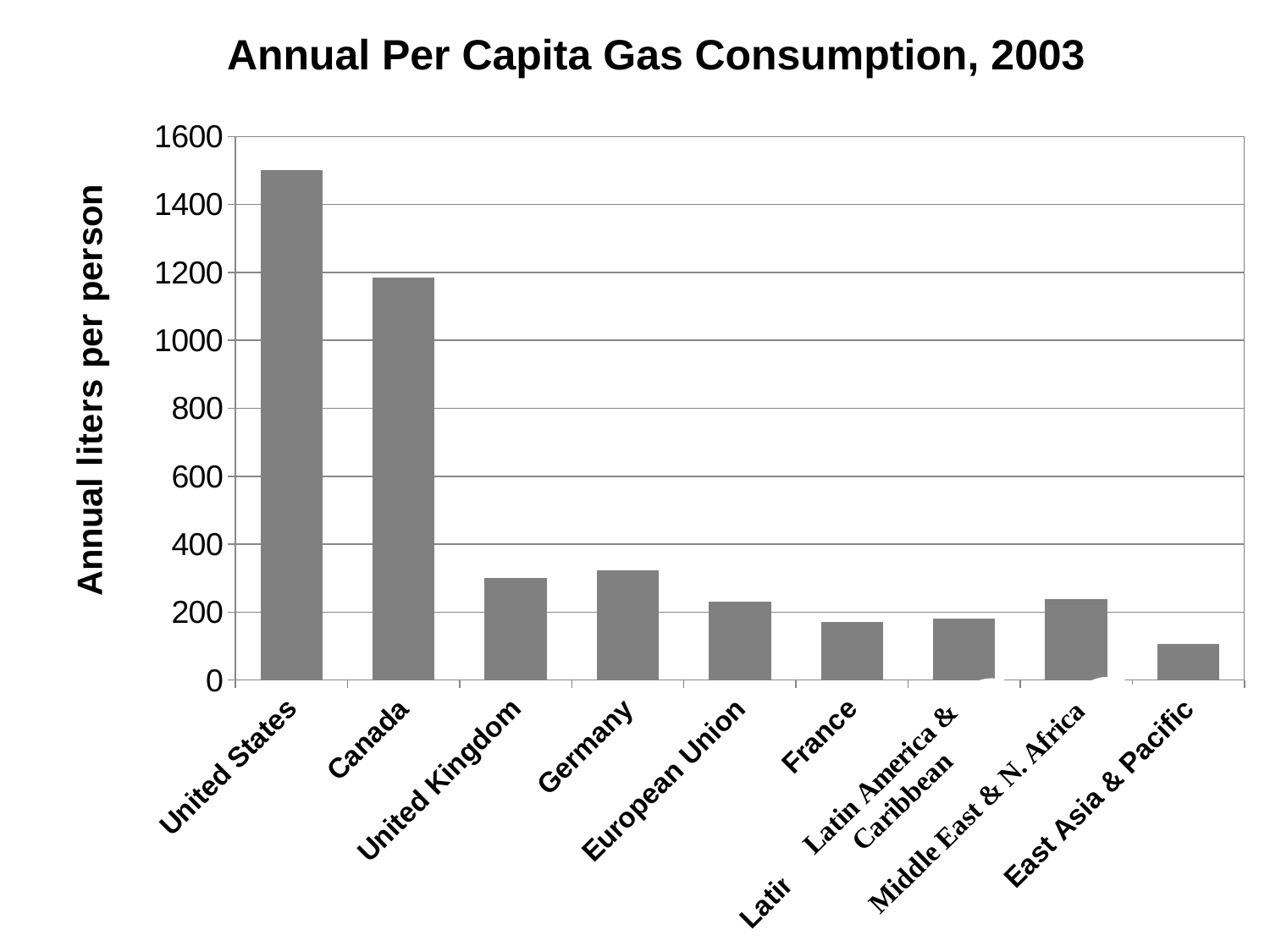
Is the value for France greater or less than 200? less What is the label on the vertical axis? Annual liters per person Is the value for Canada greater or less than 1000? greater Which has a higher annual per capita gas consumption, Canada or Germany? Canada Which country or region has the lowest annual per capita gas consumption? East Asia & Pacific Which country or region has the highest annual per capita gas consumption? United States How many countries or regions are shown on the chart? 9 Is the value for East Asia & Pacific greater or less than 200? less What is the title of the chart? Annual Per Capita Gas Consumption, 2003 What type of chart is shown on the slide? Bar chart Which has a higher annual per capita gas consumption, Middle East & N. Africa or France? Middle East & N. Africa